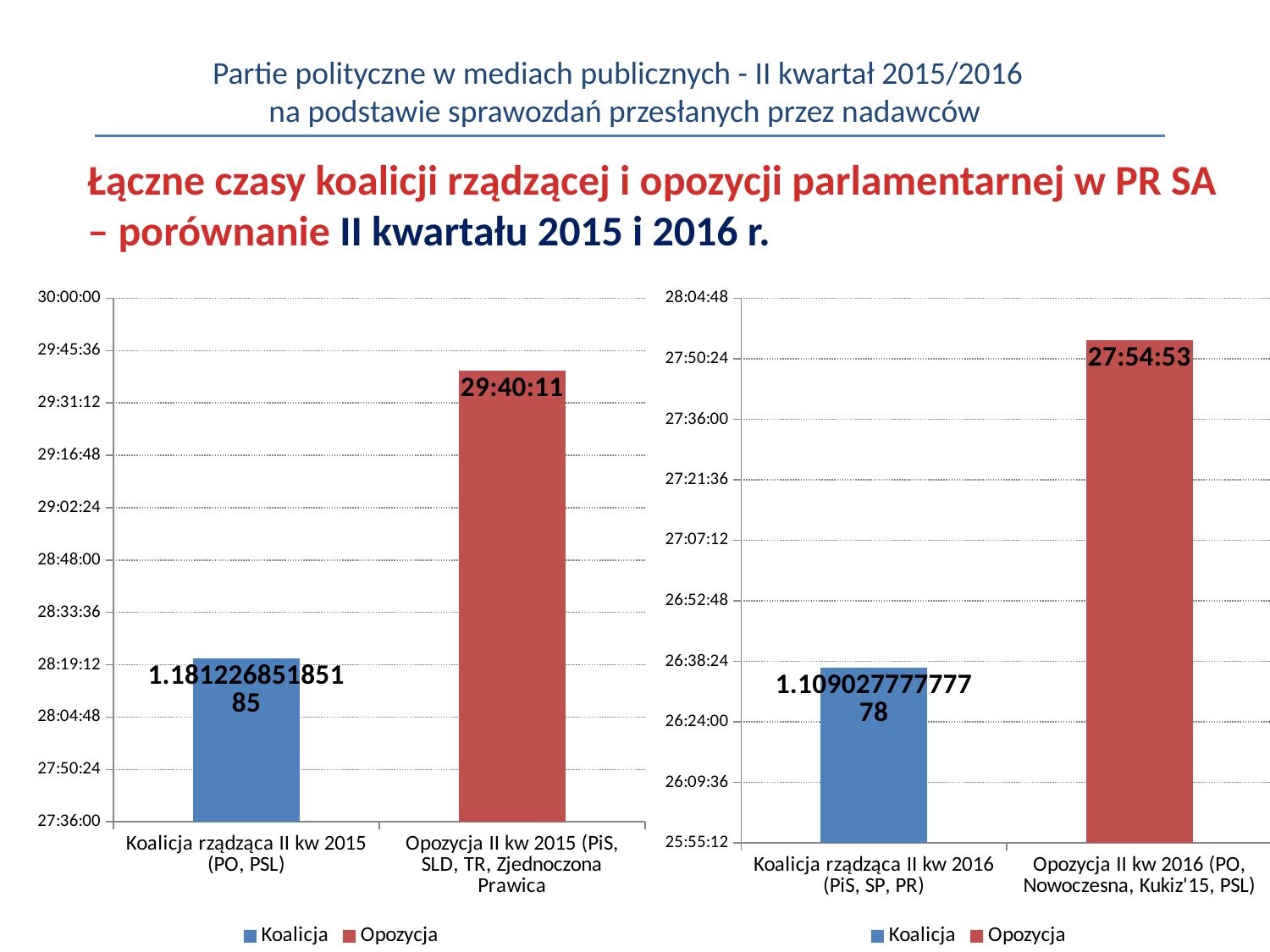
In the left chart (II kw 2015), what is the value shown for Opozycja II kw 2015 (PiS, SLD, TR, Zjednoczona Prawica)? 29:40:11 In the right chart (II kw 2016), which is larger: the bar for Koalicja rządząca or the bar for Opozycja? Opozycja In the right chart (II kw 2016), which category has the lowest bar? Koalicja rządząca II kw 2016 (PiS, SP, PR) In the left chart (II kw 2015), is the bar for Koalicja rządząca II kw 2015 (PO, PSL) greater or less than 28:33:36? less How many bars are plotted in the left chart (II kw 2015)? 2 In the right chart (II kw 2016), is the bar for Koalicja rządząca II kw 2016 (PiS, SP, PR) greater or less than 26:24:00? greater What type of chart is the left chart (II kw 2015)? Bar chart In the right chart (II kw 2016), what colour is the Opozycja bar? Red In the left chart (II kw 2015), which category has the highest bar? Opozycja II kw 2015 (PiS, SLD, TR, Zjednoczona Prawica) How many series does the legend of the right chart (II kw 2016) list? 2 In the right chart (II kw 2016), what is the value shown for Opozycja II kw 2016 (PO, Nowoczesna, Kukiz'15, PSL)? 27:54:53 In the left chart (II kw 2015), is the bar for Koalicja rządząca II kw 2015 (PO, PSL) greater or less than 28:04:48? greater